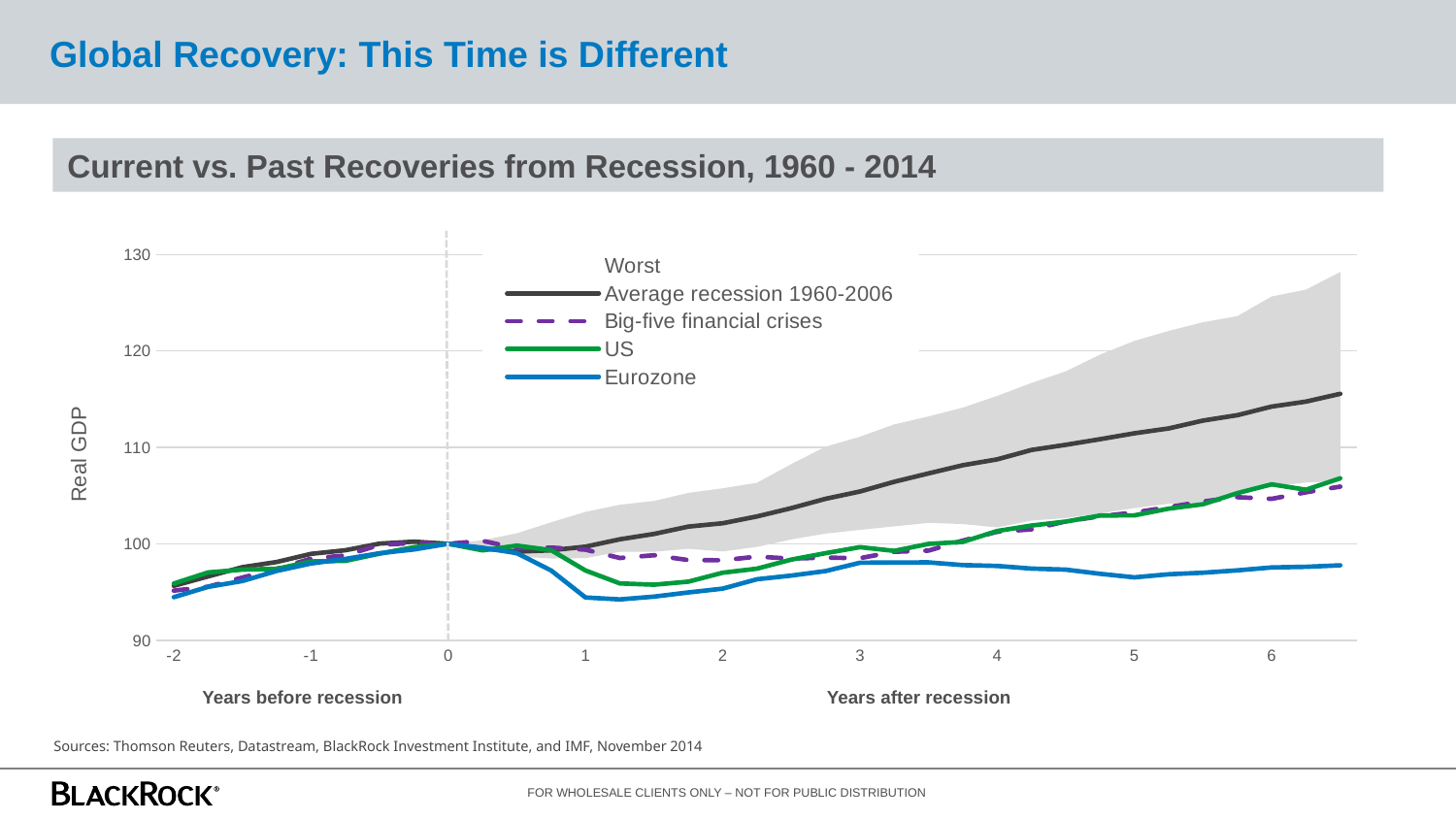
Which series has the lowest Real GDP value at year 6? Eurozone Is the Average recession 1960-2006 value at year 6 greater or less than 110? greater What is the label on the vertical axis of the chart? Real GDP Is the US value at year 6 greater or less than 100? greater Is the Eurozone value at year 6 greater or less than 100? less How many entries does the chart legend list? 5 Which series has the highest Real GDP value at year 6 (excluding the shaded Worst band)? Average recession 1960-2006 At year 6, which is larger: the US value or the Eurozone value? US What Real GDP value do all the series share at year 0? 100 What kind of chart is shown on the slide? line chart What is the title of the chart? Current vs. Past Recoveries from Recession, 1960 - 2014